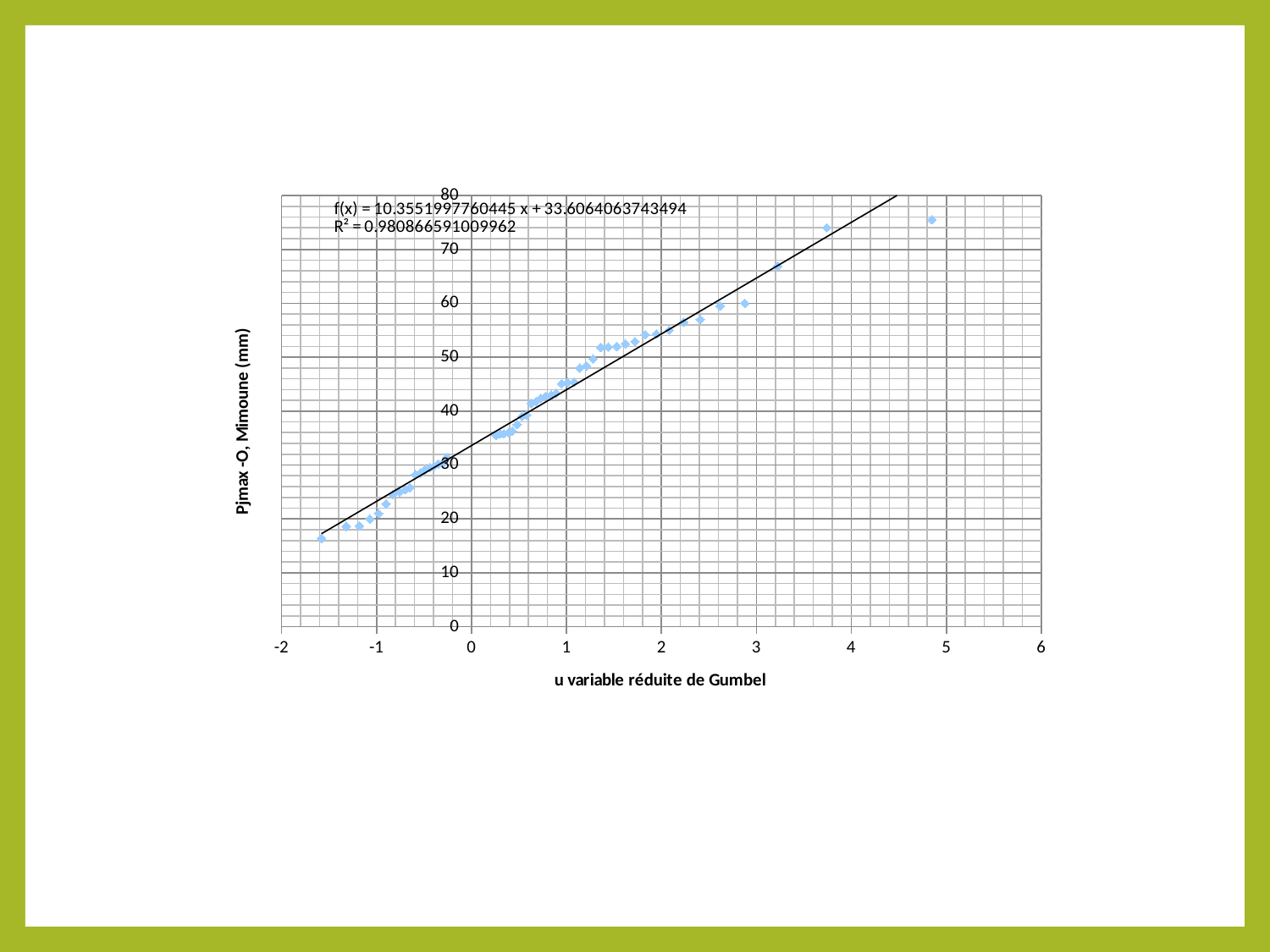
Do the plotted values rise or fall as the u variable réduite de Gumbel increases? rise What is the title of the x axis? u variable réduite de Gumbel What kind of chart is shown on the slide? scatter chart Which is larger: the y value of the rightmost plotted point or the y value of the leftmost plotted point? the rightmost point Is the plotted point at about x = 2.9 greater or less than 70 on the y axis? less Is the plotted point at about x = 3.2 greater or less than 60 on the y axis? greater What is the title of the y axis? Pjmax -O, Mimoune (mm) What is the maximum value shown on the y axis? 80 Is the highest plotted point greater or less than 70 on the y axis? greater